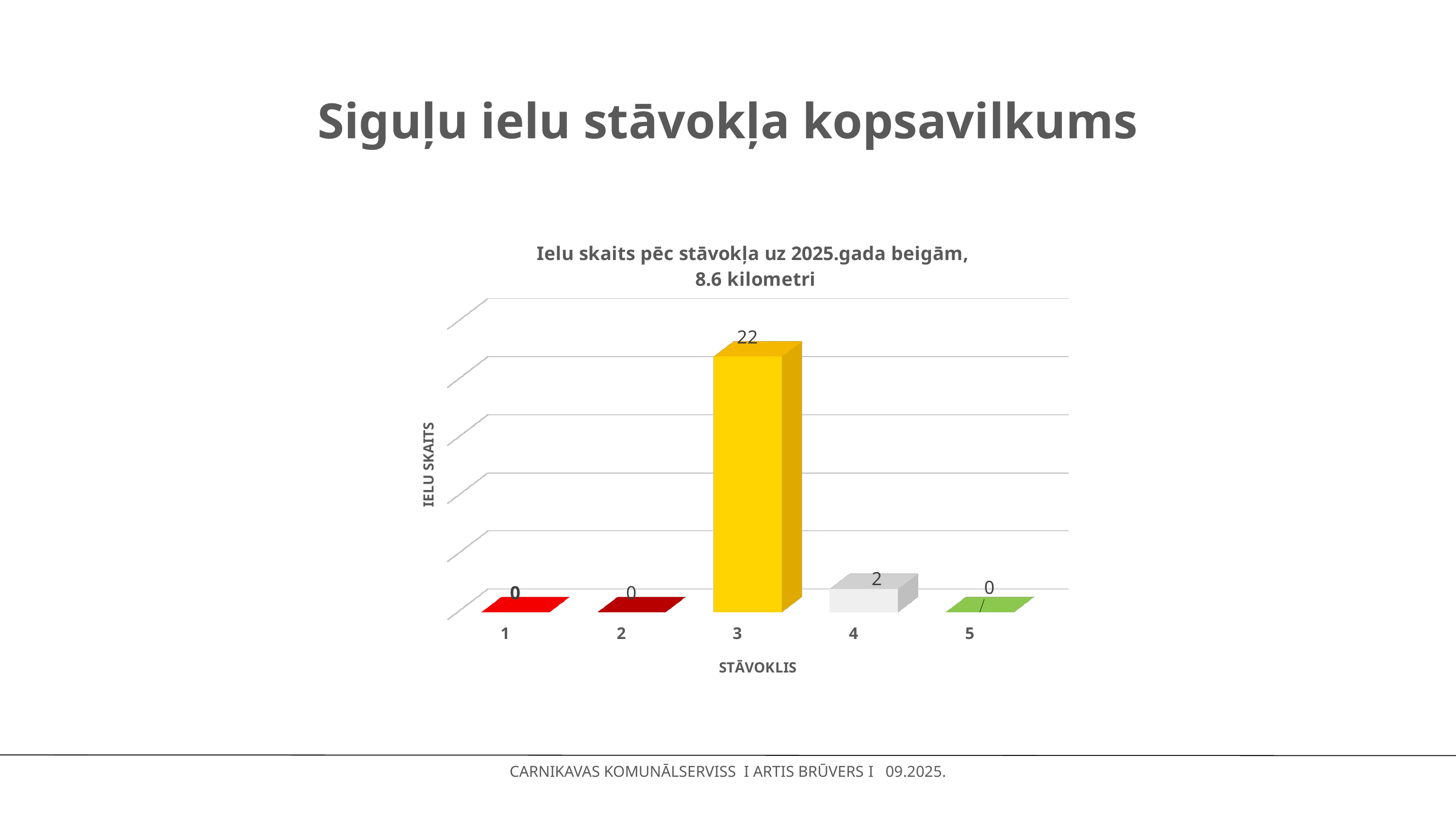
What is the value for category 4? 2 What is the value for category 1? 0 What is the value for category 3? 22 What is the value for category 5? 0 What is the label of the x axis? STĀVOKLIS How many categories have a value of 0? 3 What is the difference between the values for category 3 and category 4? 20 Which category has the highest value? 3 What is the title of the chart? Ielu skaits pēc stāvokļa uz 2025.gada beigām, 8.6 kilometri Which is larger, the value for category 3 or the value for category 4? category 3 How many categories are shown on the x axis? 5 What kind of chart is shown? bar chart